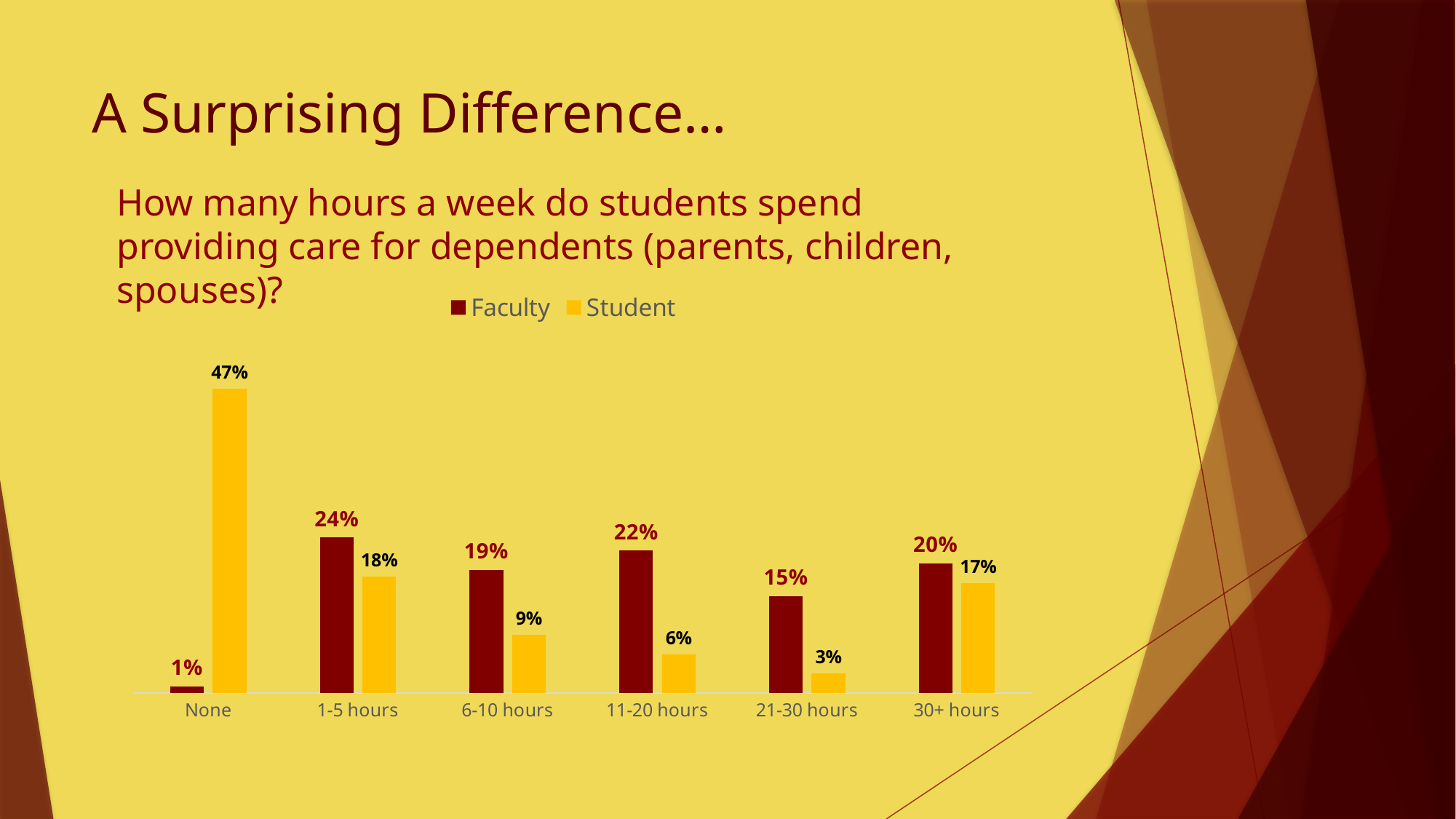
Which is larger for the 6-10 hours category, the Faculty value or the Student value? Faculty How many series does the legend list? 2 What kind of chart is shown on the slide? Bar chart How many categories are shown on the x axis? 6 What is the Student value for the None category? 47% What is the Faculty value for the 1-5 hours category? 24% Which category has the lowest Student value? 21-30 hours Which category has the highest Faculty value? 1-5 hours What is the difference between the Faculty and Student values for the 11-20 hours category? 16% What is the difference between the Student and Faculty values for the None category? 46% What is the Student value for the 21-30 hours category? 3% What is the Faculty value for the 30+ hours category? 20%